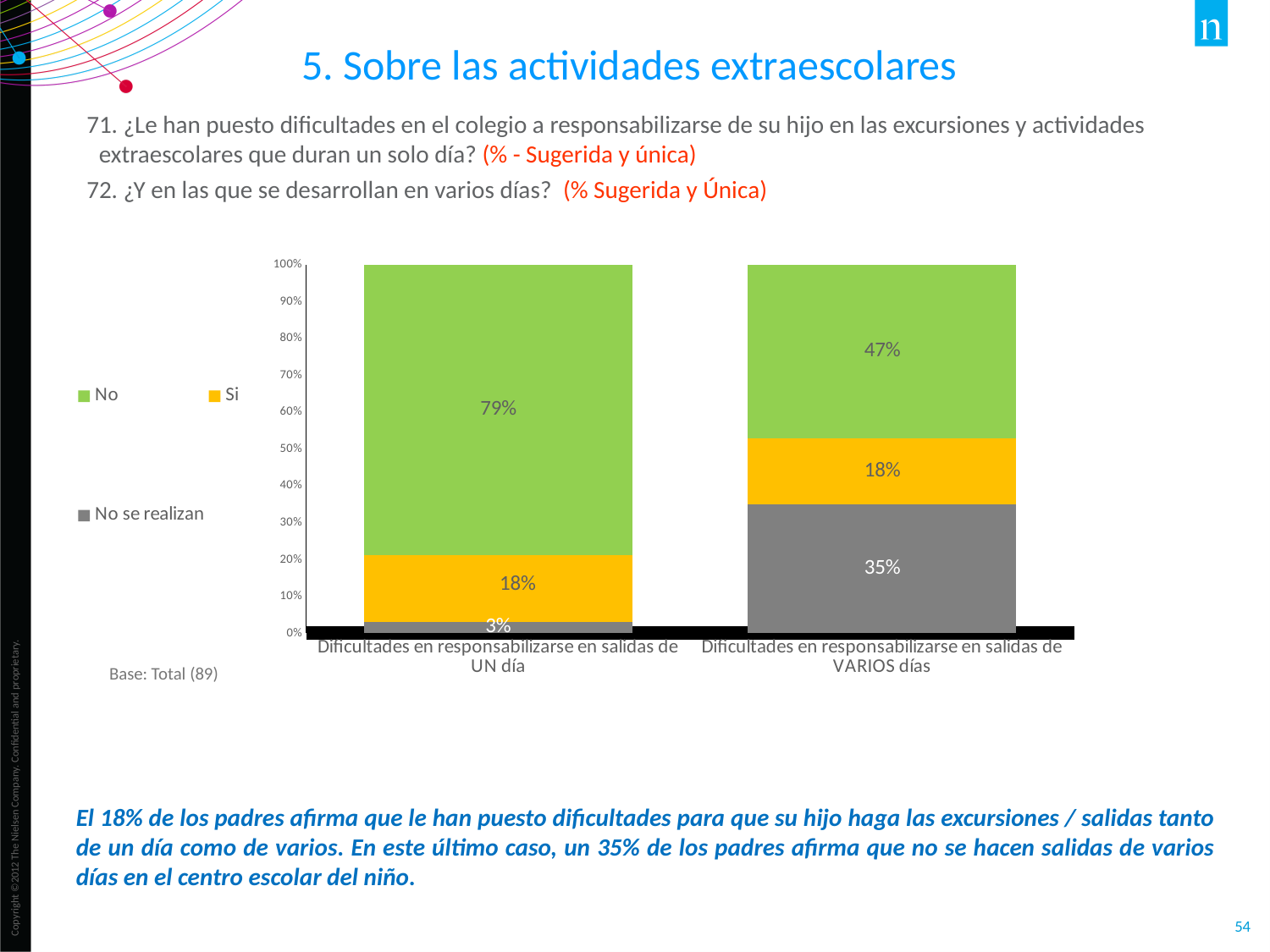
Which legend entry is shown in grey? No se realizan What kind of chart is shown on the slide? Stacked bar chart Which category has the higher value for 'No'? Dificultades en responsabilizarse en salidas de UN día What is the value of 'No se realizan' for 'Dificultades en responsabilizarse en salidas de VARIOS días'? 35% What is the difference between the 'No se realizan' values for VARIOS días and UN día? 32% What is the value of 'Si' for 'Dificultades en responsabilizarse en salidas de VARIOS días'? 18% What is the difference between the 'No' values for UN día and VARIOS días? 32% What is the value of 'No' for 'Dificultades en responsabilizarse en salidas de UN día'? 79% Which series has the lowest value in the 'Dificultades en responsabilizarse en salidas de VARIOS días' bar? Si What is the value of 'No se realizan' for 'Dificultades en responsabilizarse en salidas de UN día'? 3% How many series does the chart legend list? 3 How many categories are plotted on the x axis of the chart? 2